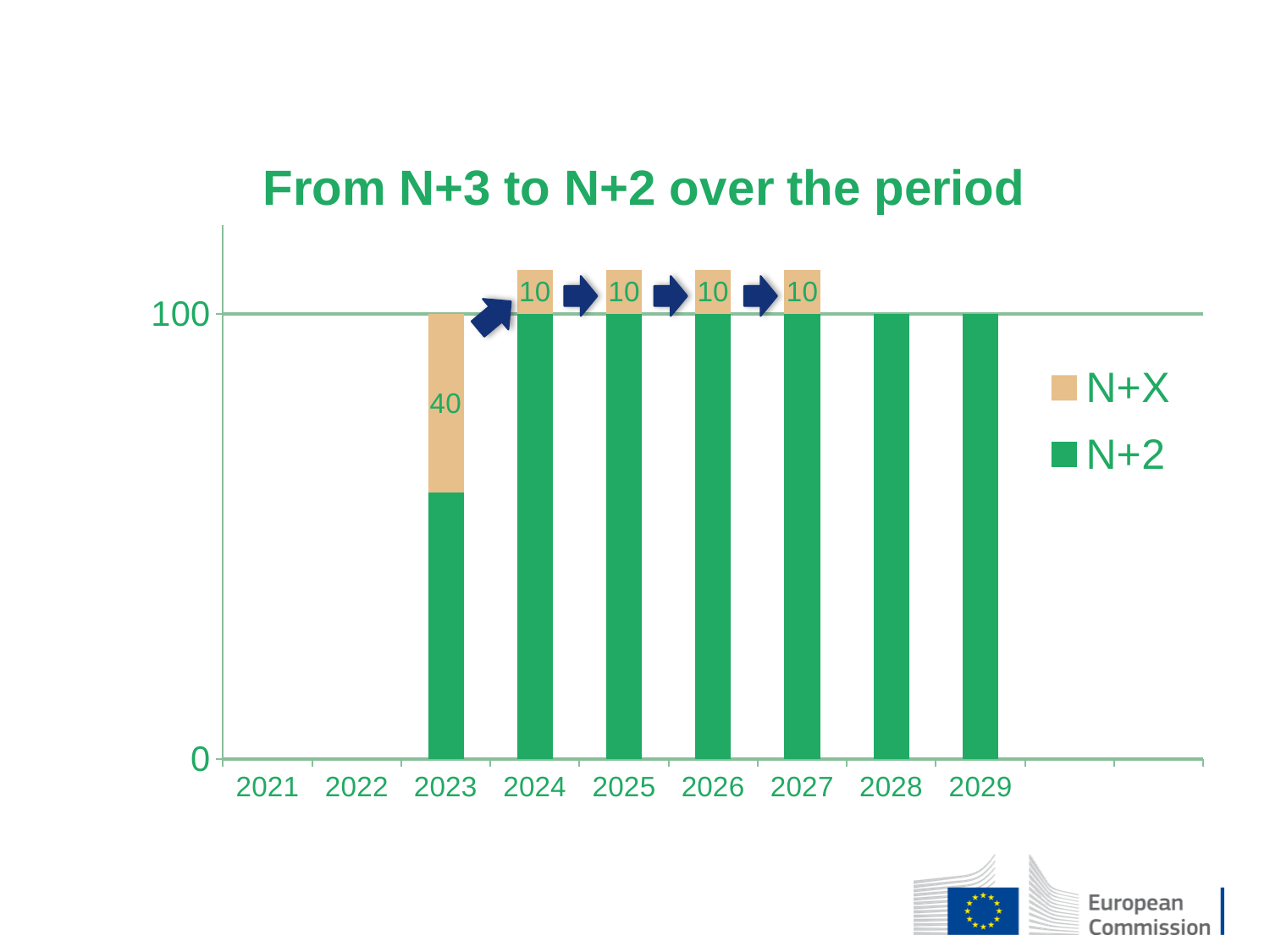
Which year has the highest N+X value? 2023 What is the N+X value for 2023? 40 What is the N+X value for 2025? 10 What kind of chart is shown? Stacked bar chart How many years have a bar plotted? 7 Is the total height of the stacked bar for 2024 greater or less than 100? greater Is the N+2 value for 2023 greater or less than 100? less What is the title of the chart? From N+3 to N+2 over the period Which is larger, the N+X value for 2023 or the N+X value for 2026? 2023 What is the difference between the N+X value for 2023 and the N+X value for 2024? 30 How many series does the legend list? 2 How many years are labelled on the x axis? 9